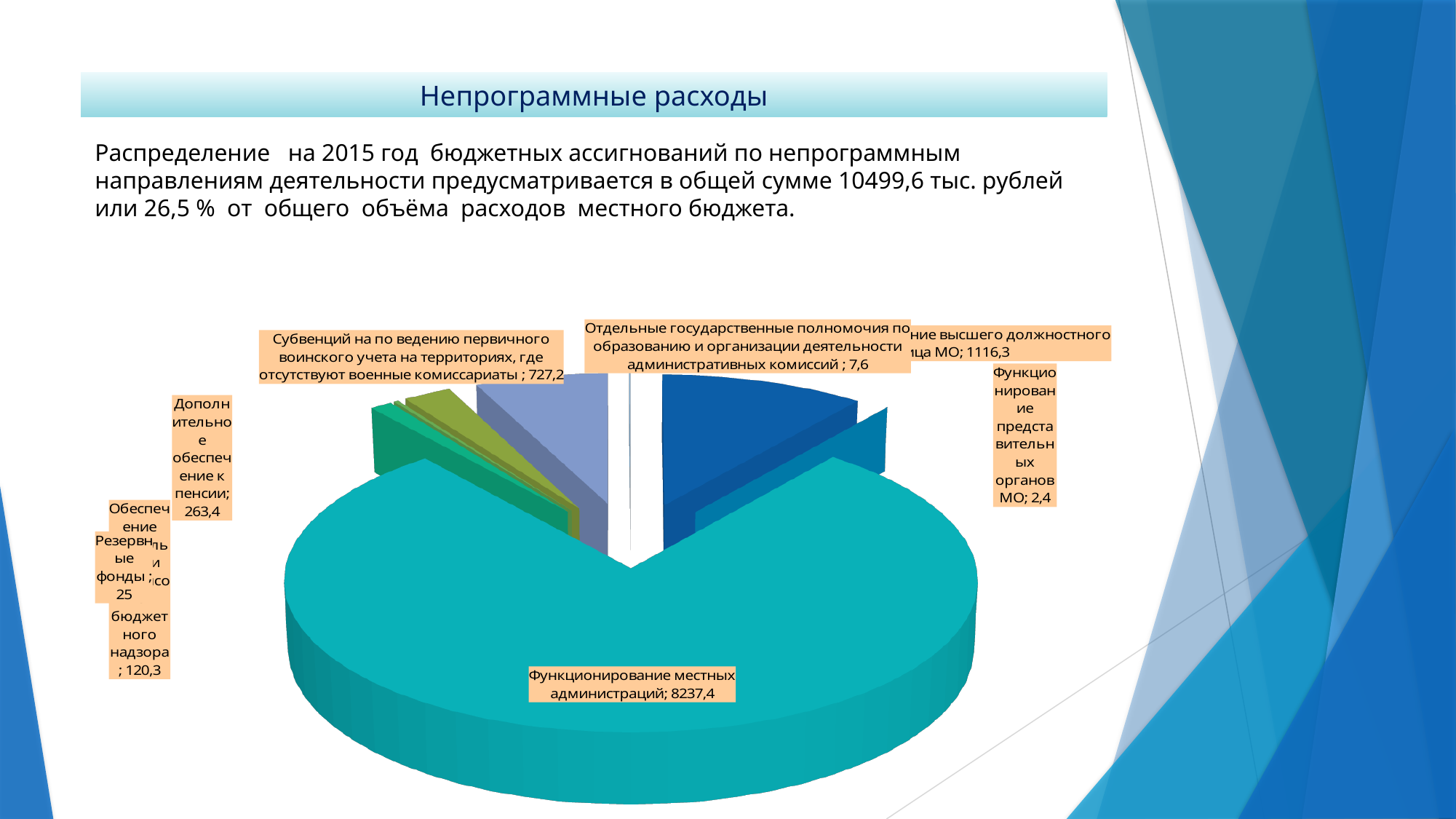
What is the value for Резервные фонды? 25 How many slices (categories) does the pie chart have? 8 Which category has the smallest value in the pie chart? Функционирование представительных органов МО What is the difference between the value for Субвенций на по ведению первичного воинского учета (727,2) and Дополнительное обеспечение к пенсии (263,4)? 463,8 What is the value for Субвенций на по ведению первичного воинского учета на территориях, где отсутствуют военные комиссариаты? 727,2 What is the value for Дополнительное обеспечение к пенсии? 263,4 What type of chart is shown on the slide? pie chart Which category has the largest slice of the pie? Функционирование местных администраций What is the value for Функционирование местных администраций? 8237,4 Which is larger: the value for Резервные фонды or the value for Дополнительное обеспечение к пенсии? Дополнительное обеспечение к пенсии What is the value for Отдельные государственные полномочия по образованию и организации деятельности административных комиссий? 7,6 What is the value for Функционирование представительных органов МО? 2,4